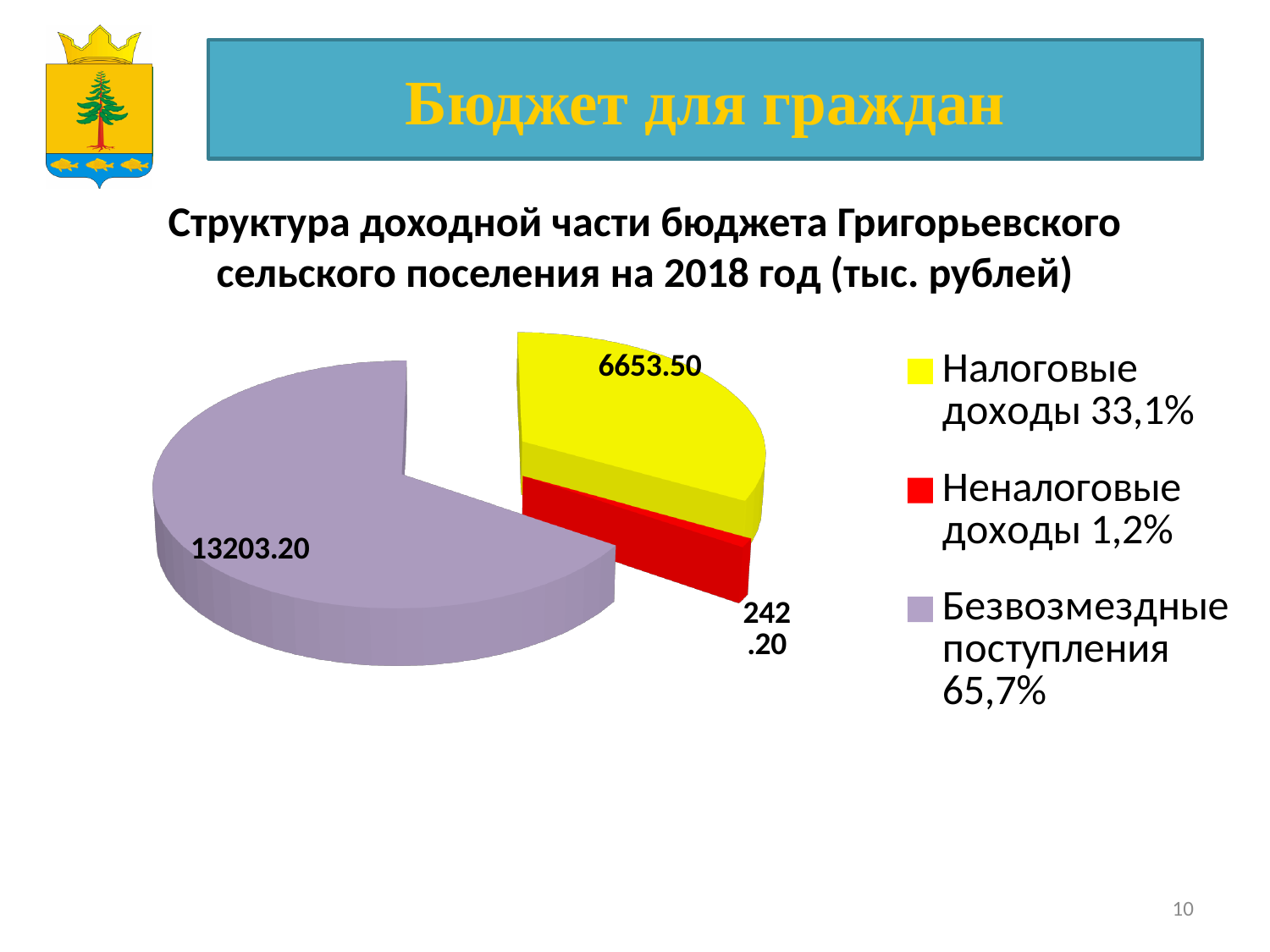
What kind of chart is shown on the slide? Pie chart What colour is the slice for Неналоговые доходы? Red What is the value for Неналоговые доходы? 242.20 What is the value for Налоговые доходы? 6653.50 Which is larger, Налоговые доходы or Неналоговые доходы? Налоговые доходы What is the difference between the values for Безвозмездные поступления and Налоговые доходы? 6549.70 Which category has the largest slice of the pie? Безвозмездные поступления What share of the pie does Безвозмездные поступления represent, according to the legend? 65,7% What share of the pie does Налоговые доходы represent, according to the legend? 33,1% Which category has the smallest slice of the pie? Неналоговые доходы How many slices does the pie chart have? 3 What is the value for Безвозмездные поступления? 13203.20